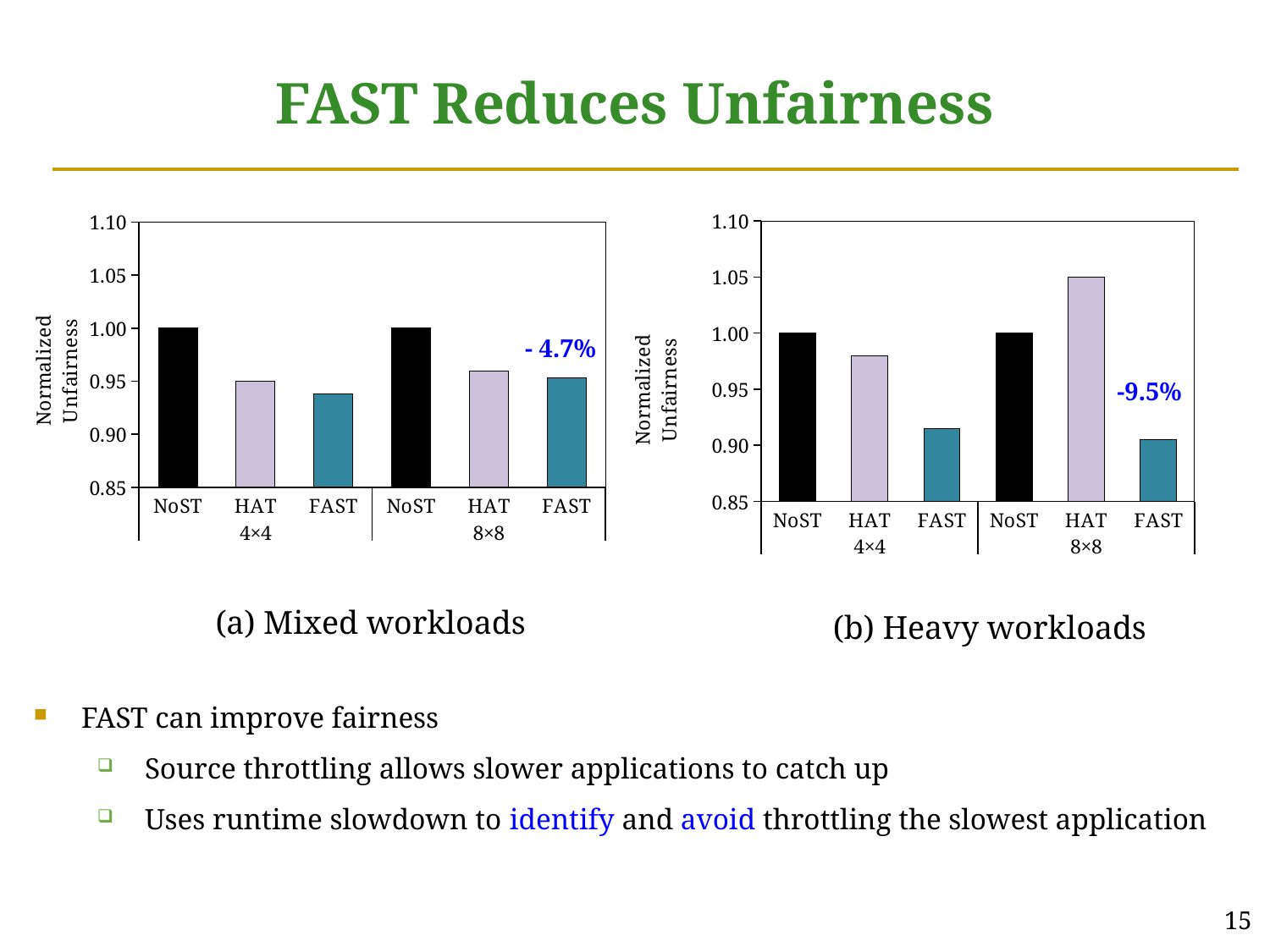
What kind of chart is used in (a) Mixed workloads? bar chart In the (b) Heavy workloads chart, is the value for FAST in the 4×4 group greater or less than 0.95? less What percentage reduction is annotated next to the FAST 8×8 bar in the (b) Heavy workloads chart? -9.5% In the (a) Mixed workloads chart, how many bars are plotted? 6 In the (a) Mixed workloads chart, which is larger in the 8×8 group: NoST or HAT? NoST In the (b) Heavy workloads chart, which is larger in the 4×4 group: HAT or FAST? HAT In the (a) Mixed workloads chart, what is the normalized unfairness for NoST in the 4×4 group? 1.00 In the (b) Heavy workloads chart, which bar is the highest? HAT 8×8 In the (a) Mixed workloads chart, is the value for HAT in the 4×4 group greater or less than 1.00? less In the (b) Heavy workloads chart, what is the normalized unfairness for NoST in the 8×8 group? 1.00 What percentage reduction is annotated next to the FAST 8×8 bar in the (a) Mixed workloads chart? -4.7% In the (b) Heavy workloads chart, is the value for HAT in the 8×8 group greater or less than 1.00? greater